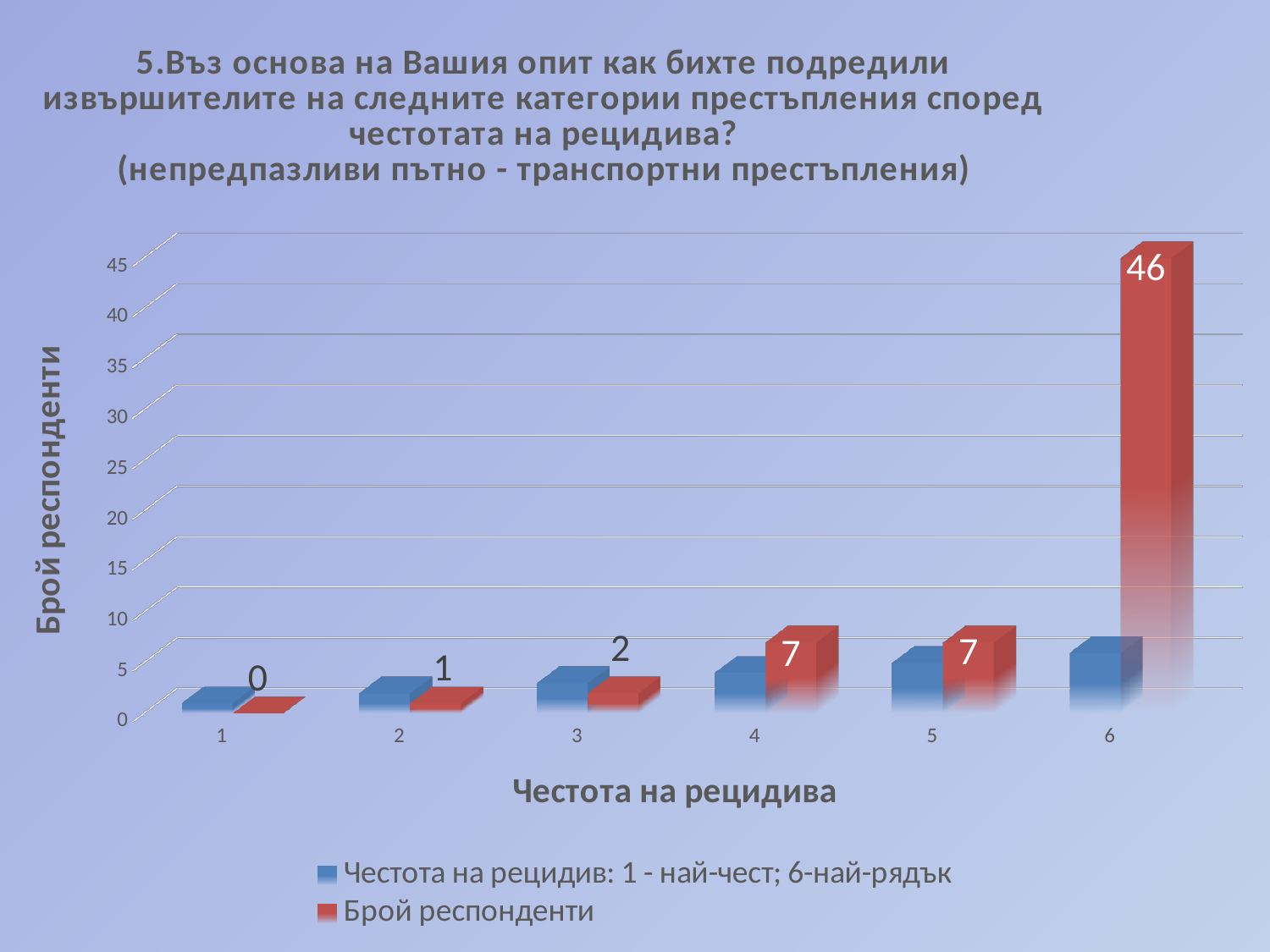
Is the blue bar for category 6 greater or less than 10? less Which category has the lowest value of Брой респонденти? 1 What is the value of Брой респонденти for category 4? 7 What is the value of Брой респонденти for category 6? 46 What is the value of Брой респонденти for category 1? 0 Which category has the highest value of Брой респонденти? 6 How many series does the legend list? 2 Which is larger, Брой респонденти for category 3 or for category 4? category 4 What is the total of Брой респонденти across all six categories? 63 What is the difference between Брой респонденти for category 6 and category 5? 39 What kind of chart is shown on the slide? bar chart How many categories are shown on the x axis? 6